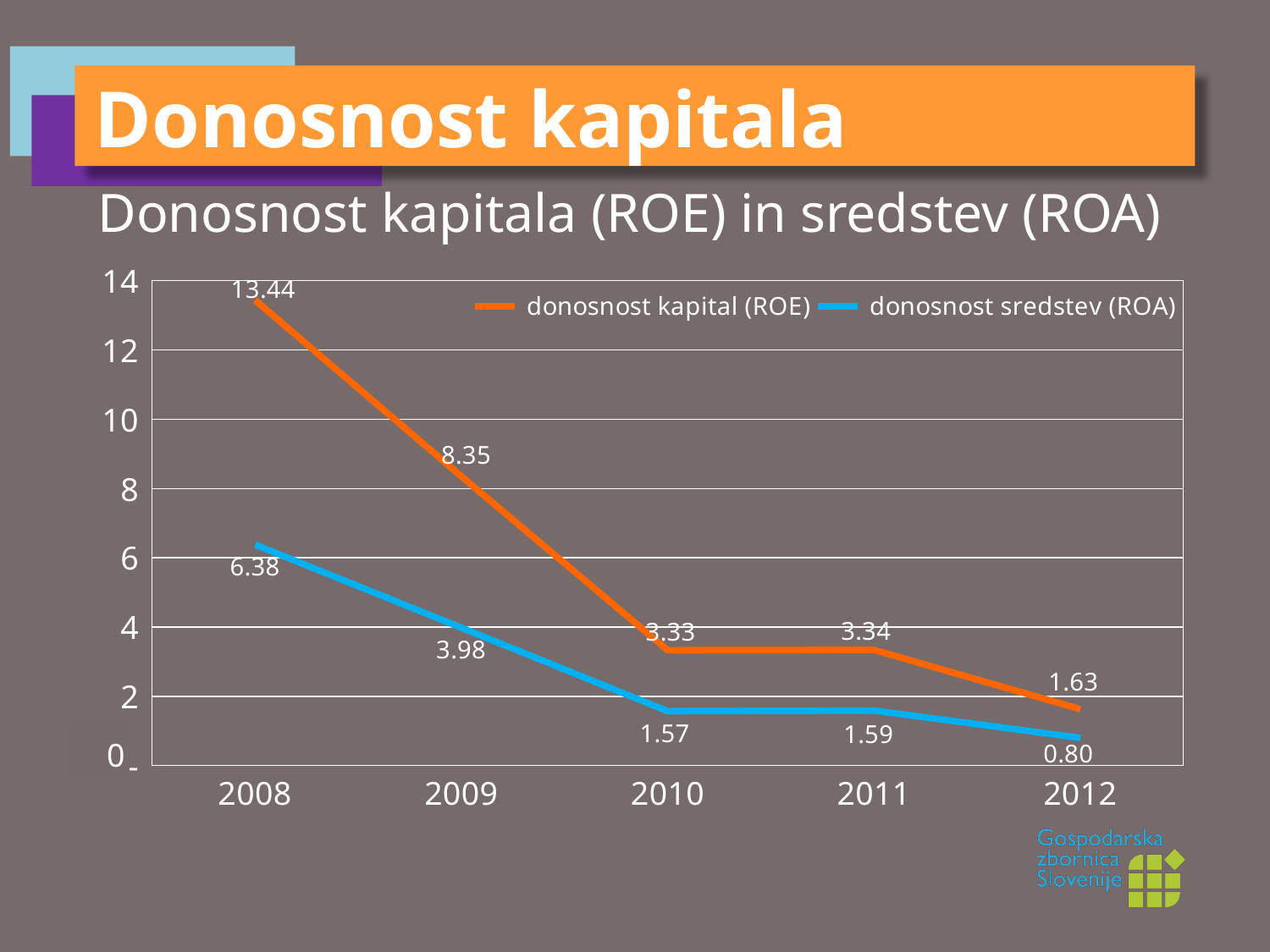
What is the value of donosnost kapital (ROE) in 2008? 13.44 In which year is donosnost sredstev (ROA) lowest? 2012 How many years are shown on the x axis? 5 What kind of chart is shown on the slide? line chart What is the value of donosnost sredstev (ROA) in 2009? 3.98 Is the value of donosnost kapital (ROE) in 2009 greater or less than 8? greater What is the value of donosnost sredstev (ROA) in 2012? 0.80 What is the difference between donosnost kapital (ROE) and donosnost sredstev (ROA) in 2008? 7.06 In which year is donosnost kapital (ROE) highest? 2008 Which is larger in 2011: donosnost kapital (ROE) or donosnost sredstev (ROA)? donosnost kapital (ROE) How many series does the legend list? 2 Does donosnost kapital (ROE) generally rise or fall from 2008 to 2012? fall